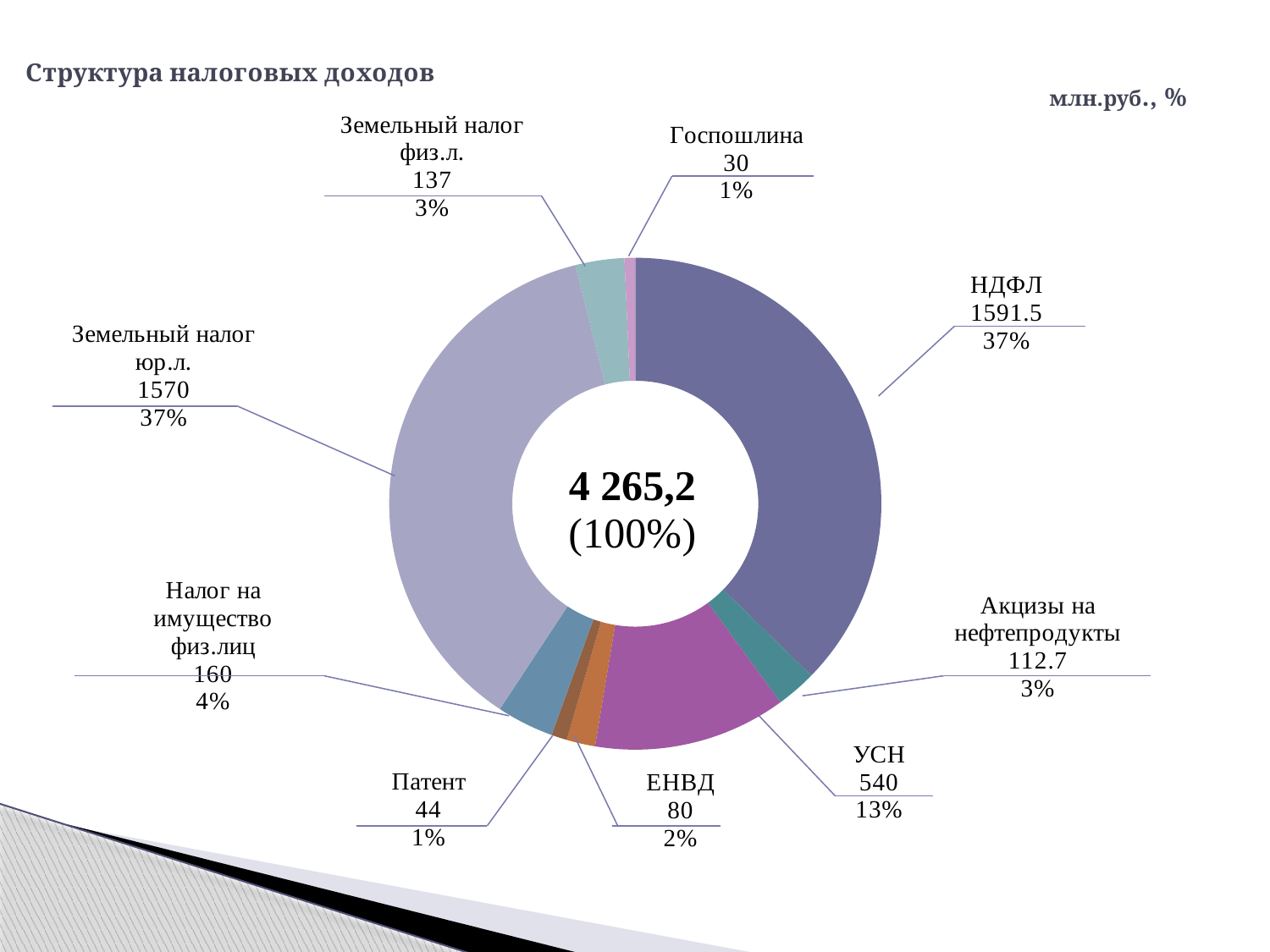
Which is larger, the value for Патент or the value for ЕНВД? ЕНВД What share of the total does Земельный налог юр.л. represent? 37% What is the value for УСН? 540 What kind of chart is shown on the slide? Doughnut (pie) chart What total value is printed in the centre of the chart? 4 265,2 (100%) What is the difference between the values for Налог на имущество физ.лиц and Земельный налог физ.л.? 23 What share of the total does ЕНВД represent? 2% How many categories are shown in the chart? 9 Which category has the lowest value? Госпошлина Which category has the highest value according to the printed labels? НДФЛ What is the value for НДФЛ? 1591.5 What is the value for Акцизы на нефтепродукты? 112.7